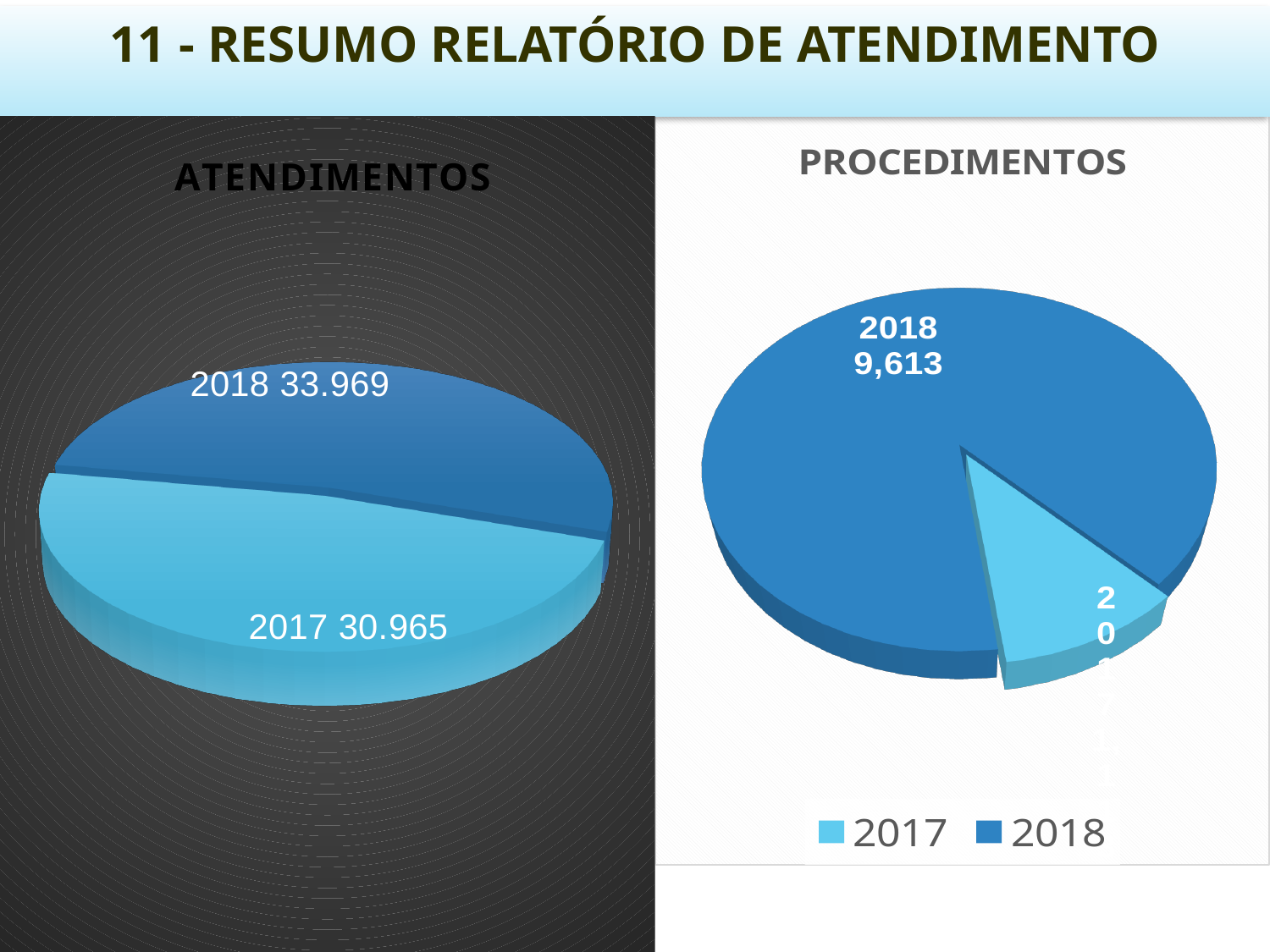
In the ATENDIMENTOS chart, what is the value for 2017? 30.965 In the ATENDIMENTOS chart, which year has the larger value? 2018 In the ATENDIMENTOS chart, how many slices does the pie have? 2 What kind of chart is the ATENDIMENTOS chart? Pie chart In the ATENDIMENTOS chart, which year has the smaller value? 2017 In the PROCEDIMENTOS chart, which year has the larger slice, 2017 or 2018? 2018 In the ATENDIMENTOS chart, what is the difference between the 2018 and 2017 values? 3.004 What kind of chart is the PROCEDIMENTOS chart? Pie chart In the PROCEDIMENTOS chart, what is the value for 2018? 9,613 What is the title of the chart on the right side of the slide? PROCEDIMENTOS In the ATENDIMENTOS chart, what is the value for 2018? 33.969 In the PROCEDIMENTOS chart, how many entries does the legend list? 2